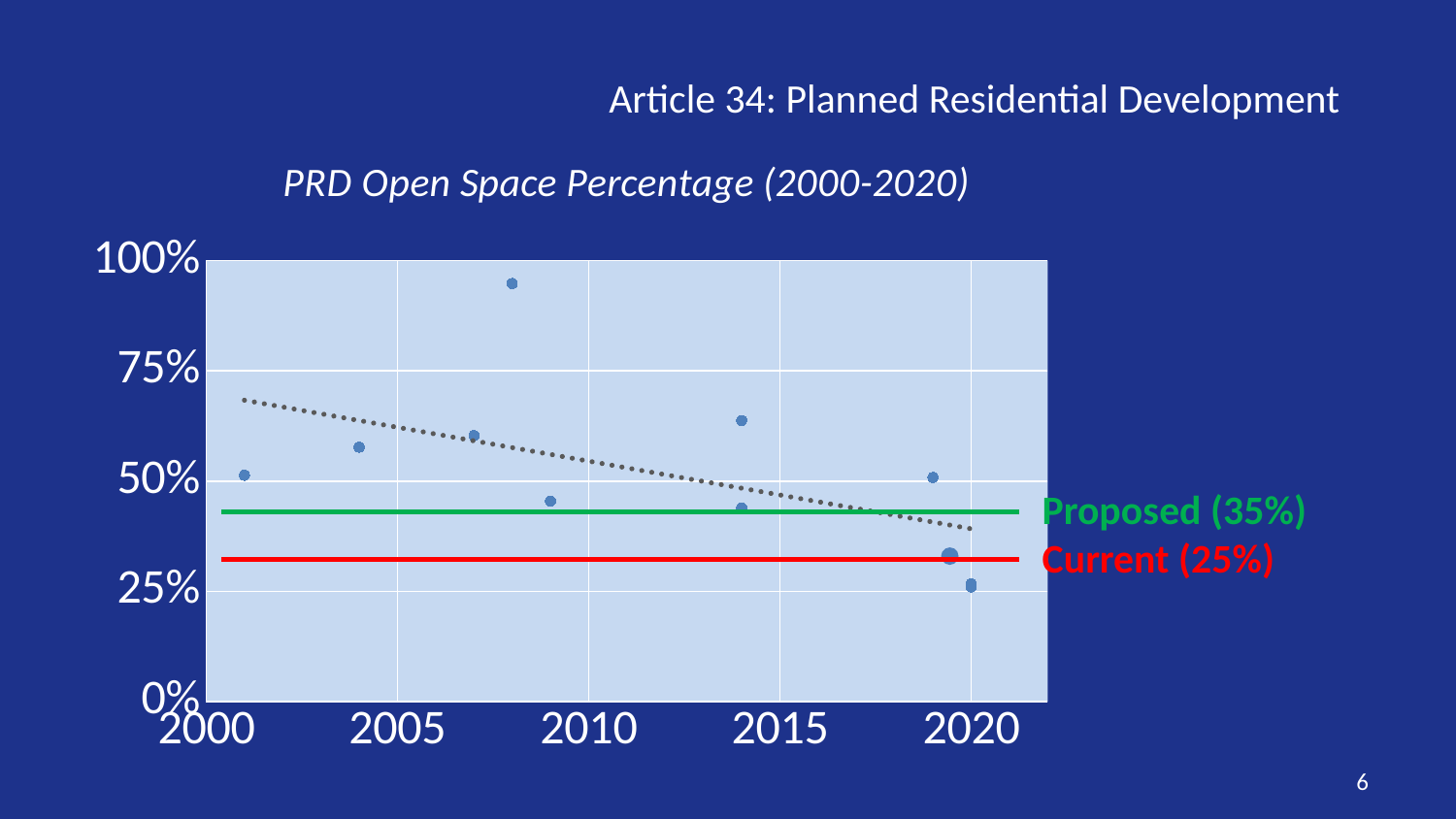
Is the highest plotted point on the chart greater or less than 75%? greater Is the lowest plotted point on the chart, near 2020, greater or less than 50%? less Is the plotted point near 2004 greater or less than 50%? greater Which is larger, the Proposed open space percentage or the Current open space percentage? Proposed What percentage does the red horizontal line labelled 'Current' represent? 25% What is the maximum value shown on the y axis of the chart? 100% What kind of chart is shown on the slide? scatter chart What is the title of the chart? PRD Open Space Percentage (2000-2020) According to the dotted trend line, do the PRD open space percentages rise or fall from 2000 to 2020? fall What percentage does the green horizontal line labelled 'Proposed' represent? 35% What is the difference between the Proposed (35%) and Current (25%) open space percentages? 10%